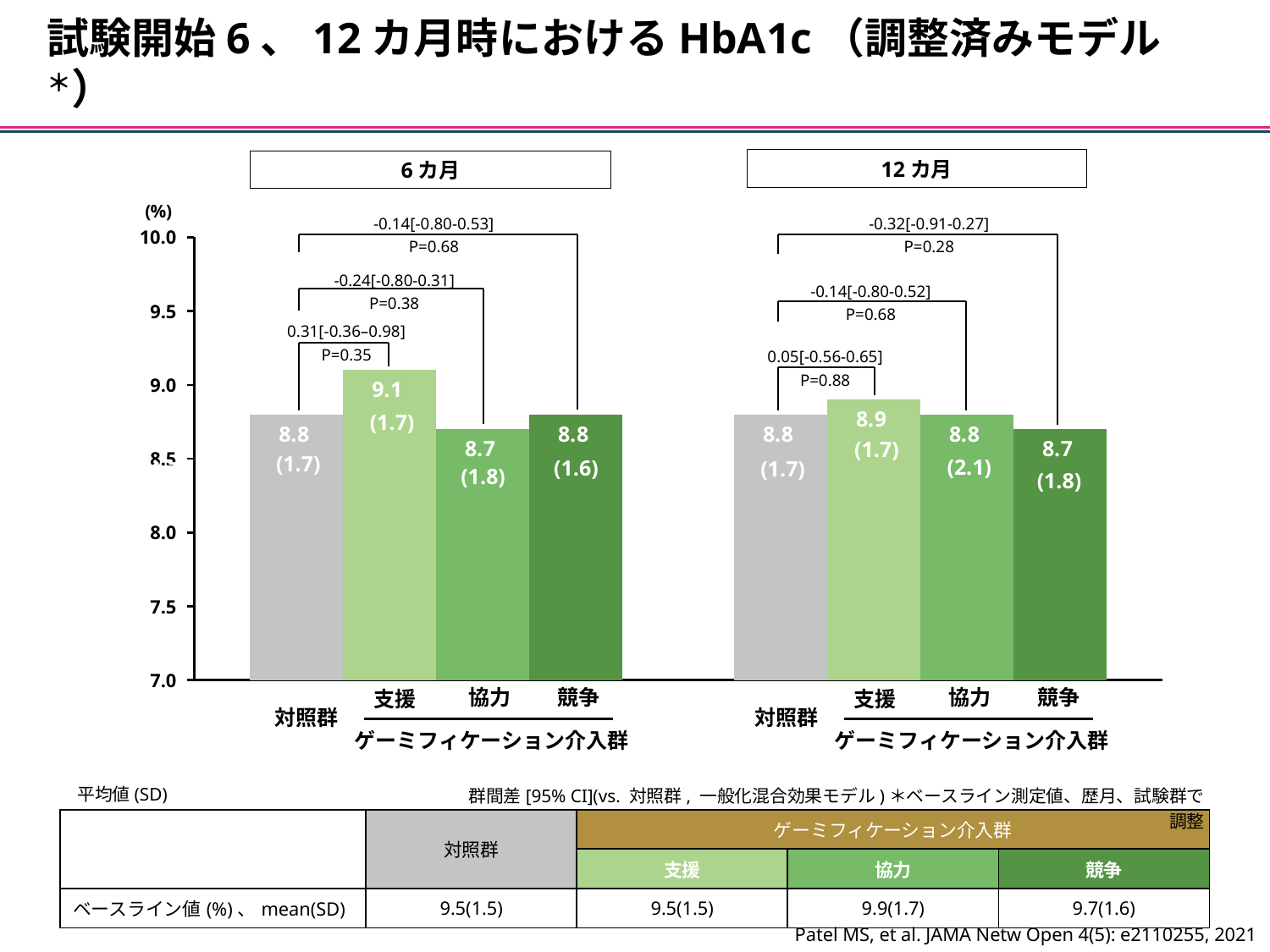
In the 12カ月 chart, which is larger, the HbA1c value for 支援 or for 競争? 支援 In the 6カ月 chart, what is the HbA1c value for 協力? 8.7 In the 12カ月 chart, which group has the highest HbA1c value? 支援 In the 6カ月 chart, which group has the highest HbA1c value? 支援 In the 12カ月 chart, what is the HbA1c value for 競争? 8.7 In the 6カ月 chart, which group has the lowest HbA1c value? 協力 What kind of chart is used on this slide? bar chart How many bars are shown in the 12カ月 chart? 4 In the 12カ月 chart, what is the SD shown in parentheses for 協力? 2.1 In the 6カ月 chart, is the value for 対照群 greater or less than 8.5? greater In the 6カ月 chart, what is the HbA1c value for 支援? 9.1 In the 6カ月 chart, what is the difference between the HbA1c values for 支援 and 協力? 0.4